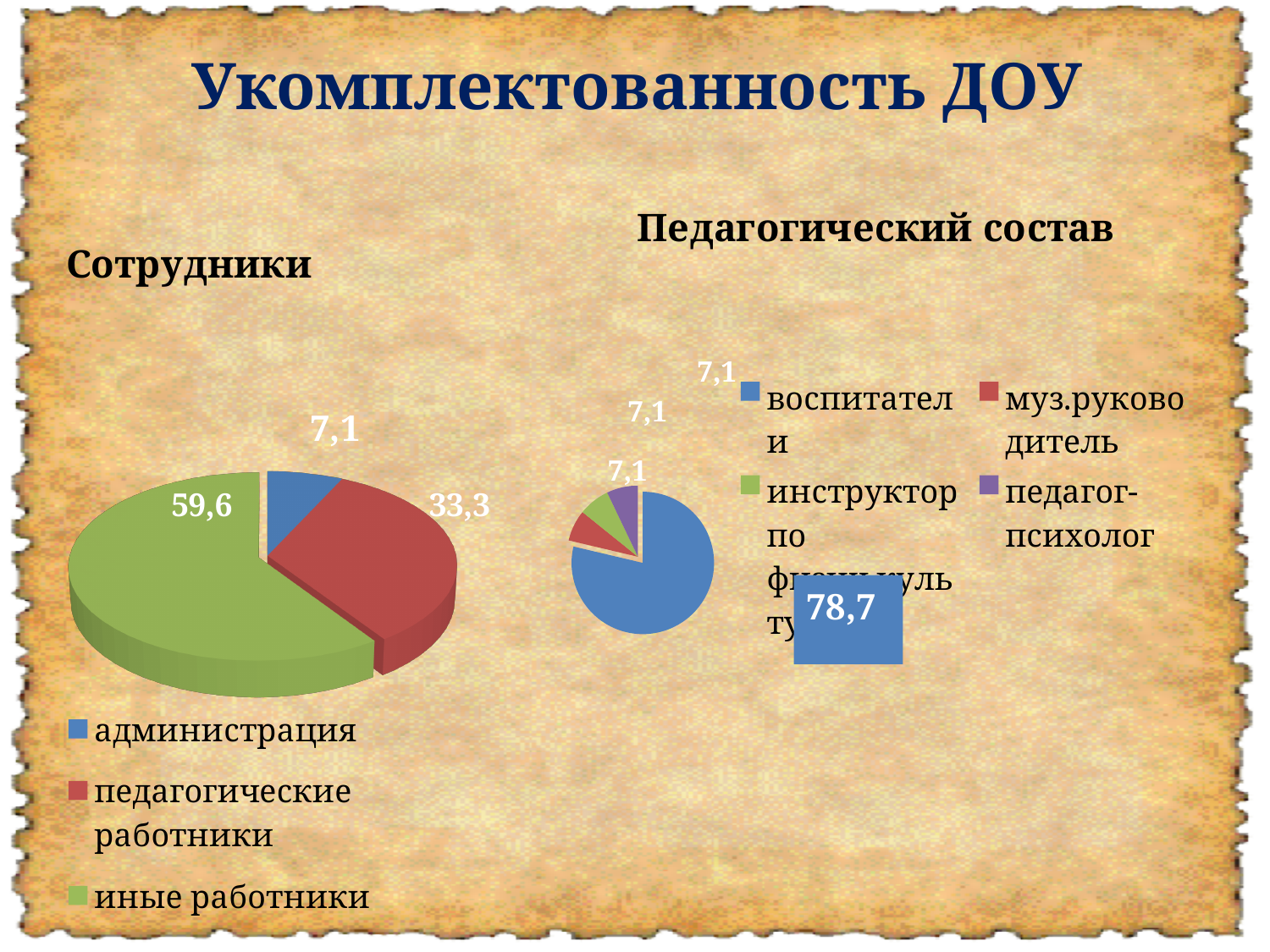
In the 'Сотрудники' chart, how many categories does the legend list? 3 In the 'Сотрудники' chart, which category has the smallest slice? администрация In the 'Сотрудники' chart, what is the value for 'педагогические работники'? 33,3 What type of chart is the 'Сотрудники' chart? pie chart In the 'Педагогический состав' chart, what is the value for 'педагог-психолог'? 7,1 In the 'Сотрудники' chart, what is the difference between the values for 'иные работники' and 'педагогические работники'? 26,3 In the 'Педагогический состав' chart, what is the value for 'воспитатели'? 78,7 In the 'Сотрудники' chart, which category has the largest slice? иные работники In the 'Сотрудники' chart, what is the value for 'иные работники'? 59,6 In the 'Педагогический состав' chart, which category has the largest slice? воспитатели In the 'Сотрудники' chart, what is the value for 'администрация'? 7,1 In the 'Педагогический состав' chart, how many categories does the legend list? 4